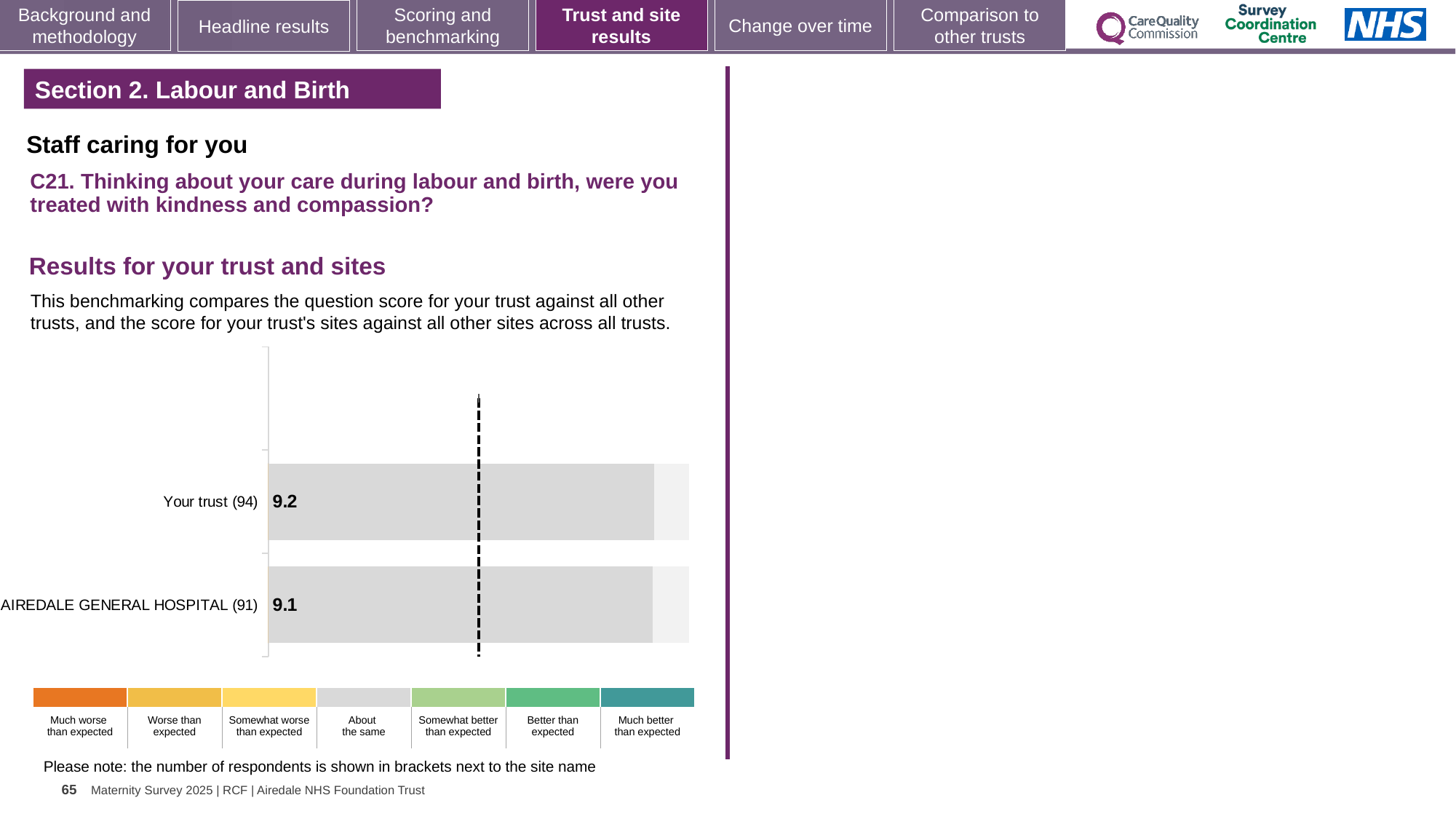
Which bar has the higher score, Your trust or AIREDALE GENERAL HOSPITAL? Your trust How many bars are plotted on the chart? 2 What is the score for Your trust (94)? 9.2 What is the score for AIREDALE GENERAL HOSPITAL (91)? 9.1 How many respondents are shown in brackets for AIREDALE GENERAL HOSPITAL? 91 Which benchmark category does the grey colour of the bars correspond to in the key? About the same Which category has the lowest score on the chart? AIREDALE GENERAL HOSPITAL (91) What kind of chart is shown on the slide? Bar chart How many respondents are shown in brackets for Your trust? 94 What is the difference between the score for Your trust and the score for AIREDALE GENERAL HOSPITAL? 0.1 Which category has the highest score on the chart? Your trust (94) How many benchmark categories does the colour key below the chart list? 7